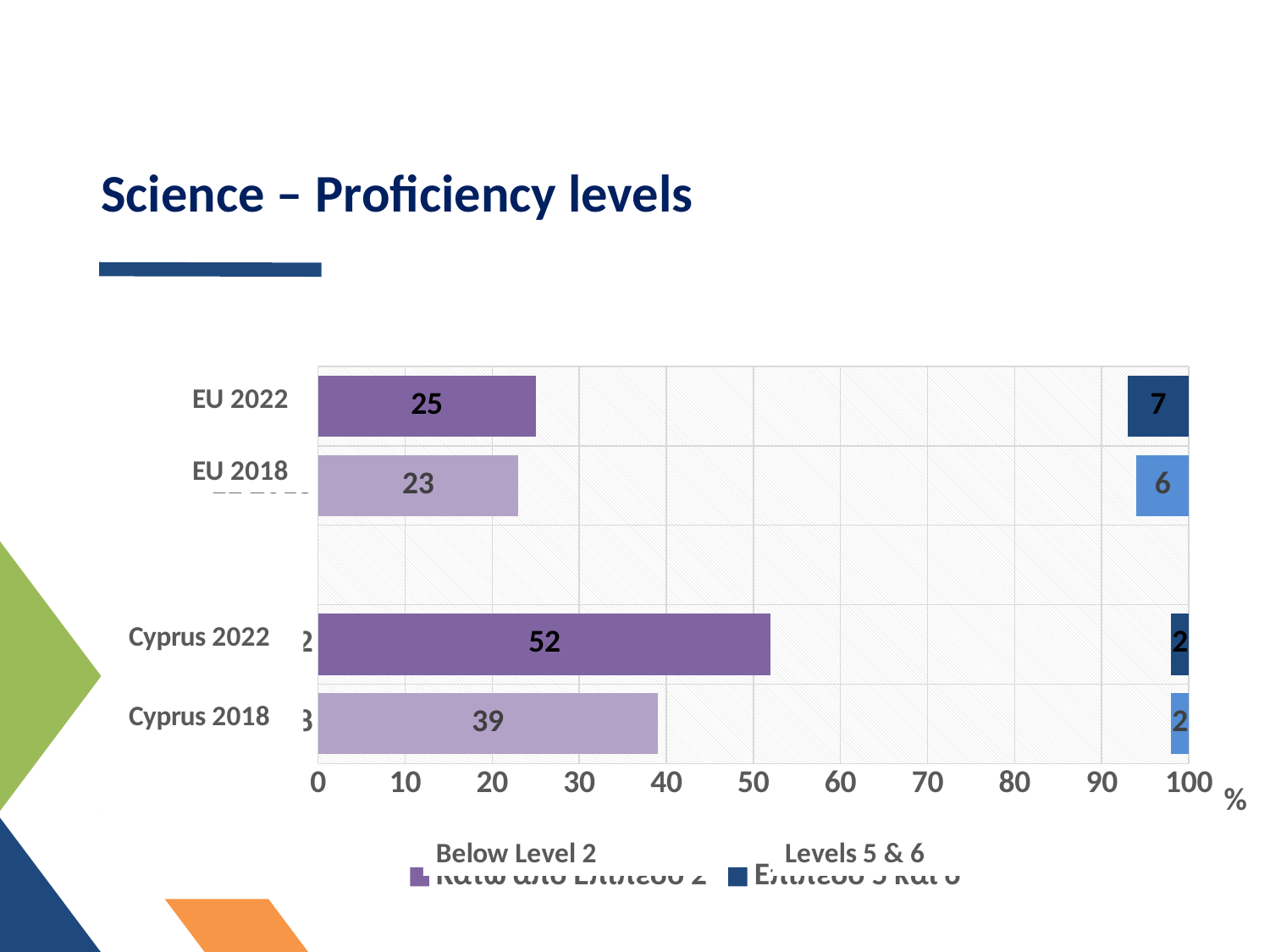
What is the Levels 5 & 6 value for Cyprus 2018? 2 Is the Below Level 2 value for Cyprus 2022 greater or less than 50? greater What is the Below Level 2 value for Cyprus 2022? 52 What is the difference between the Below Level 2 values for Cyprus 2022 and Cyprus 2018? 13 Which category has the highest Below Level 2 value? Cyprus 2022 How many categories are shown on the chart? 4 How many series does the legend list? 2 What is the Levels 5 & 6 value for EU 2022? 7 What is the Below Level 2 value for EU 2018? 23 Which is larger, the Levels 5 & 6 value for EU 2022 or for EU 2018? EU 2022 Which category has the lowest Below Level 2 value? EU 2018 What kind of chart is shown on the slide? Bar chart